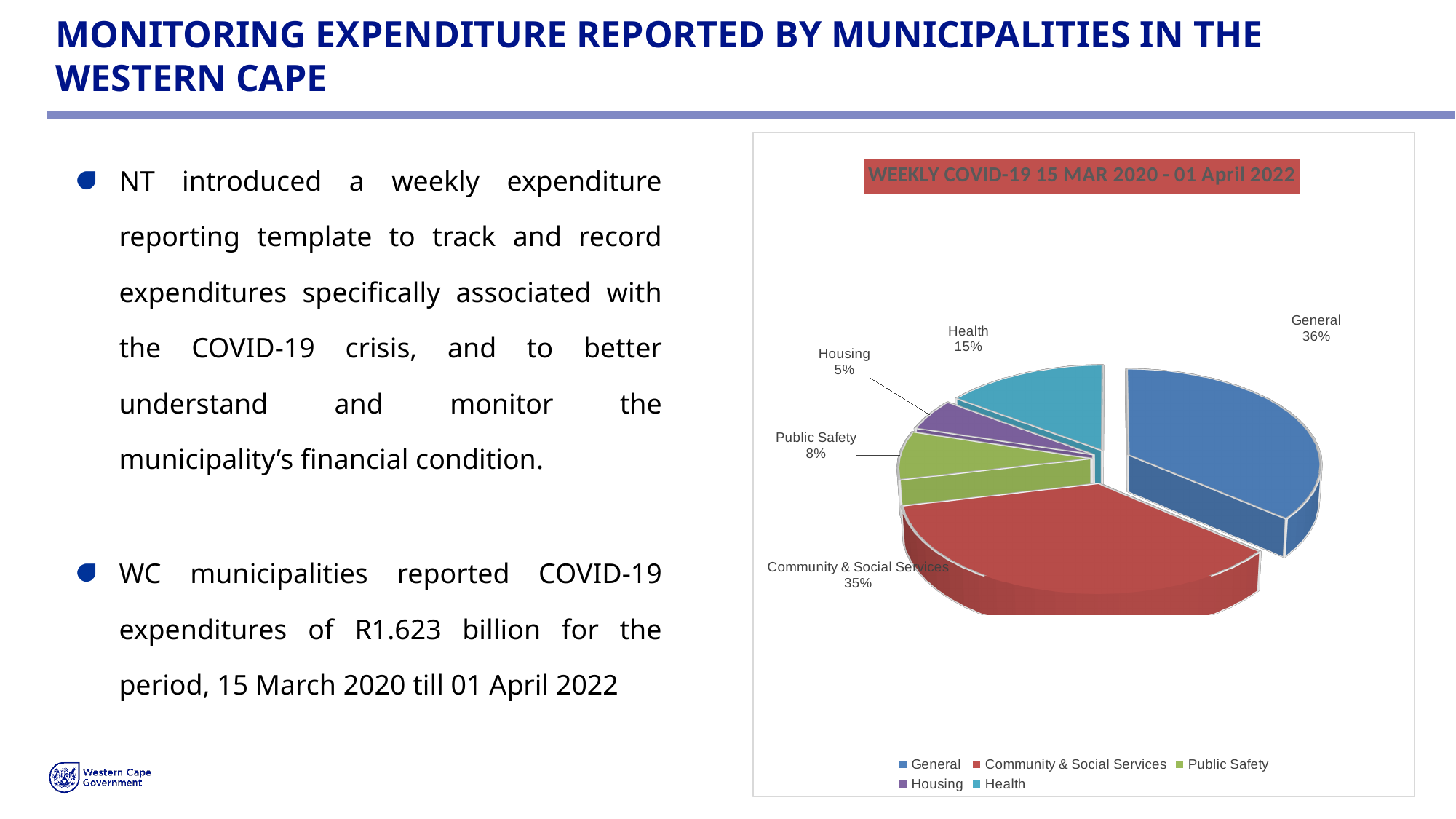
What percentage is shown for Housing? 5% What percentage is shown for Public Safety? 8% What is the title of the chart? WEEKLY COVID-19 15 MAR 2020 - 01 April 2022 Which is larger, the share for Health or the share for Housing? Health What percentage is shown for Health? 15% Which category has the smallest share of the pie? Housing What is the difference in percentage points between Health and Public Safety? 7 What percentage is shown for Community & Social Services? 35% What share of the pie does General account for? 36% Which category has the largest share of the pie? General What type of chart is shown on the slide? Pie chart How many categories are shown in the pie chart? 5